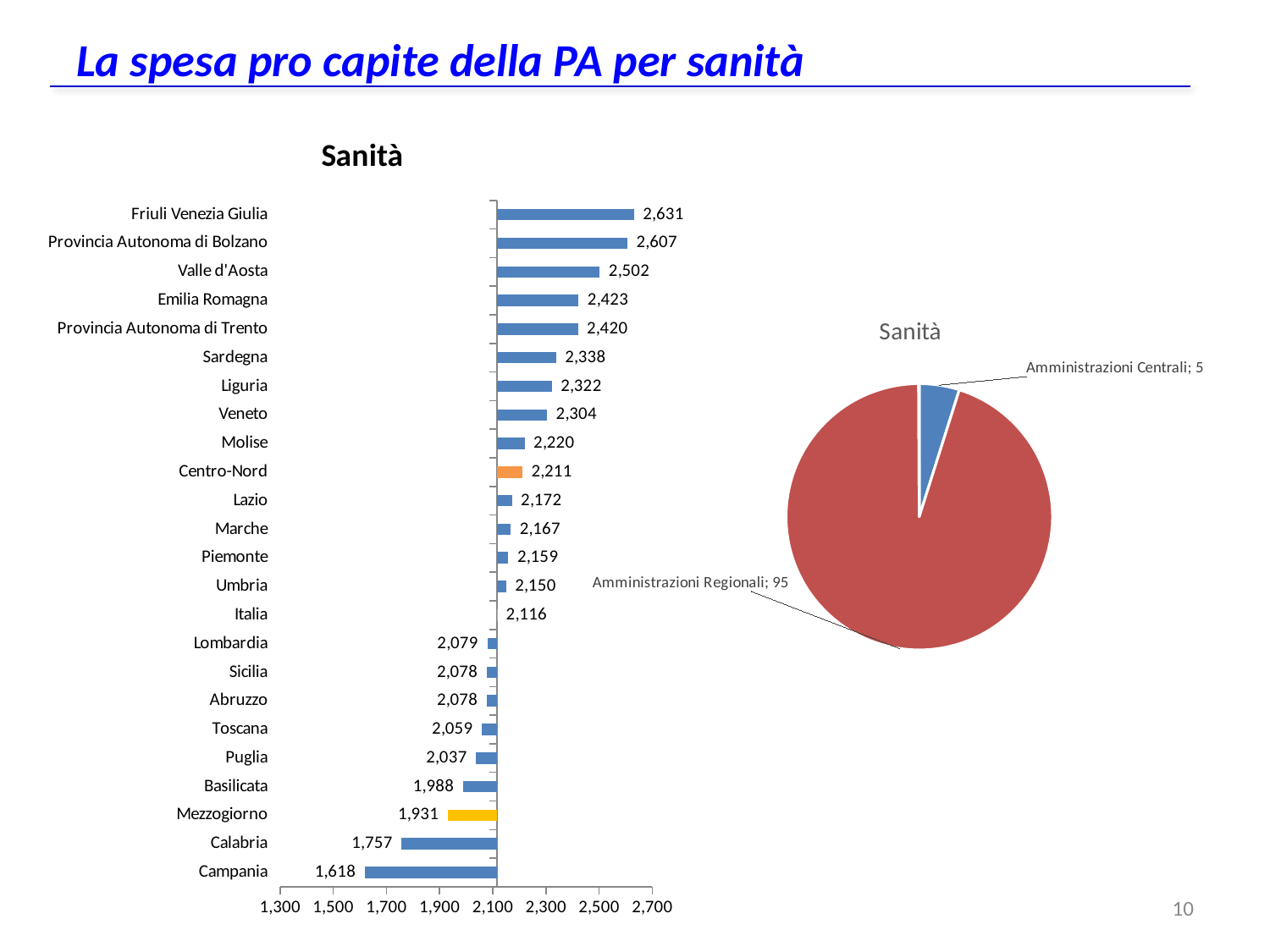
In the pie chart on the right, what is the value for Amministrazioni Regionali? 95 In the bar chart on the left, what is the value for Italia? 2,116 What kind of chart is the chart on the left of the slide? Bar chart In the bar chart on the left, what is the difference between the values for Centro-Nord and Mezzogiorno? 280 In the pie chart on the right, what share of the total does Amministrazioni Centrali represent? 5% In the bar chart on the left, what is the value for Friuli Venezia Giulia? 2,631 In the bar chart on the left, which category has the lowest value? Campania In the bar chart on the left, which category has the highest value? Friuli Venezia Giulia In the pie chart on the right, what is the value for Amministrazioni Centrali? 5 In the bar chart on the left, which is larger, the value for Sardegna or the value for Liguria? Sardegna In the bar chart on the left, what is the value for Campania? 1,618 In the bar chart on the left, how many categories are shown? 24